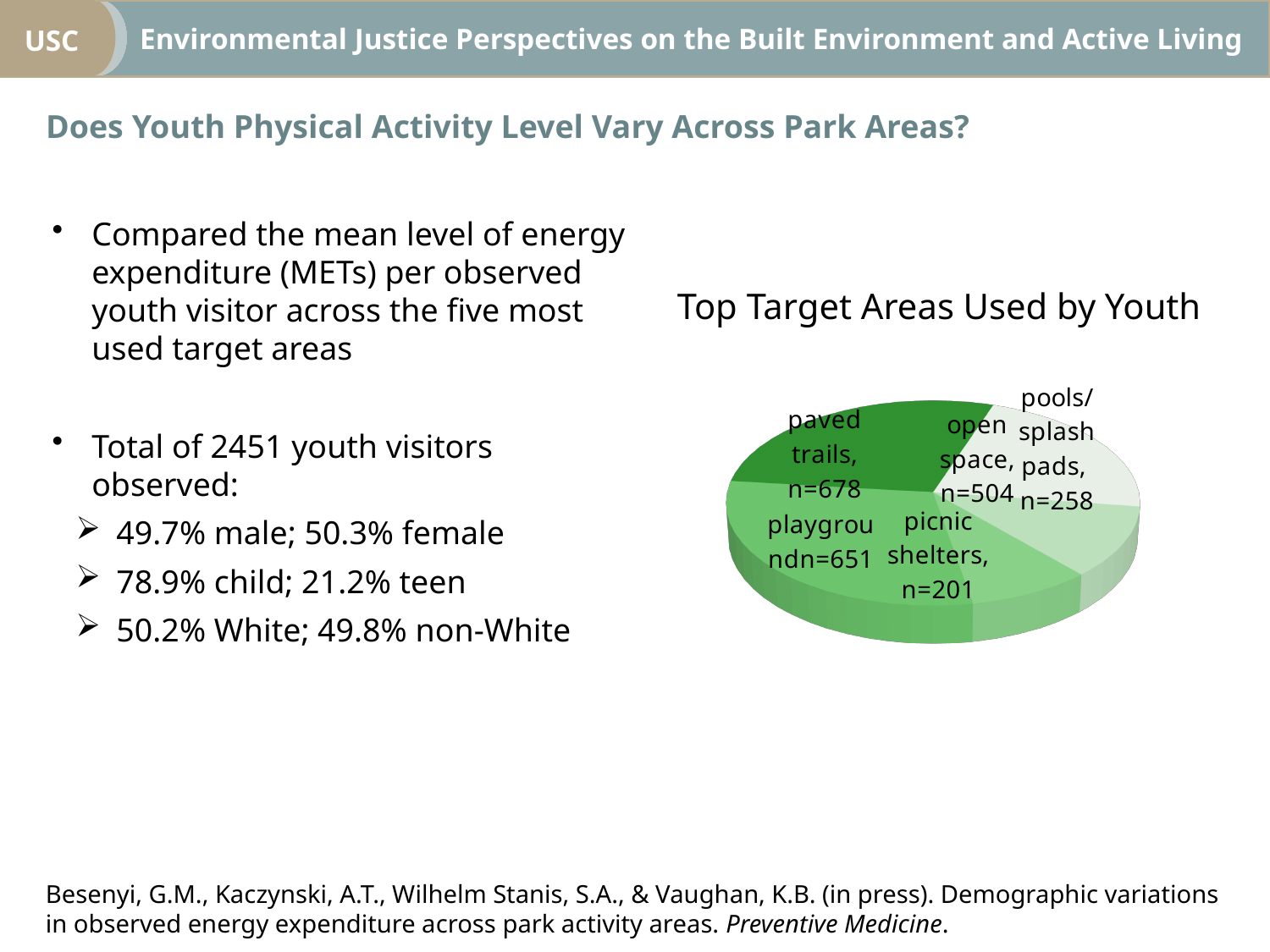
What is the difference in youth visitors between paved trails and playground? 27 Which has more youth visitors, playground or open space? playground What is the difference in youth visitors between open space and pools/splash pads? 246 Which target area has the largest number of youth visitors? paved trails How many target areas are shown in the pie chart? 5 Which target area has the smallest number of youth visitors? picnic shelters What is the title of the chart? Top Target Areas Used by Youth What is the number of youth observed in open space? n=504 What is the number of youth observed at pools/splash pads? n=258 What is the number of youth observed at paved trails? n=678 What type of chart is shown on the slide? pie chart What is the number of youth observed at picnic shelters? n=201